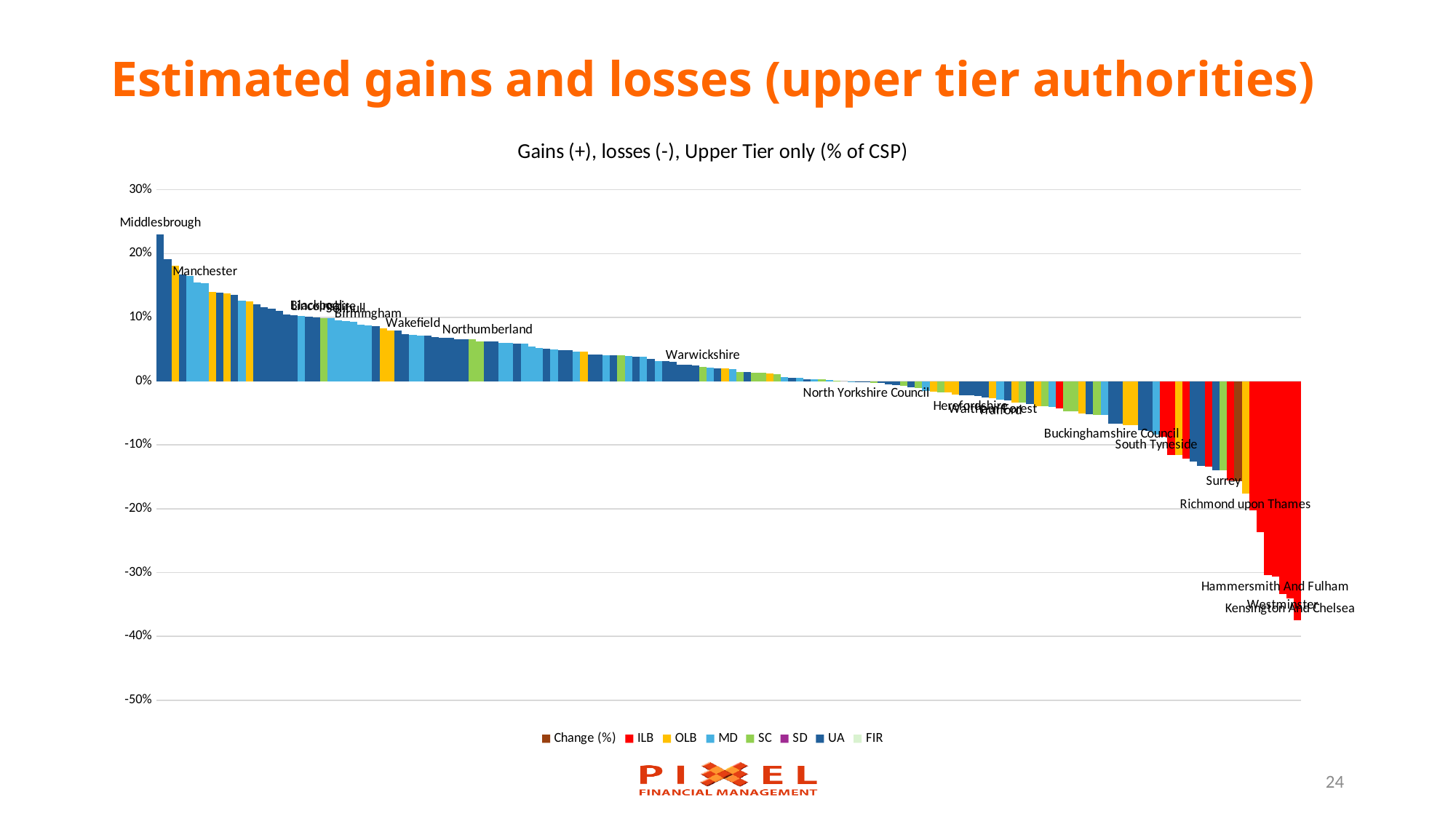
What kind of chart is shown on the slide? bar chart What is the title of the chart? Gains (+), losses (-), Upper Tier only (% of CSP) Is the value for Warwickshire greater or less than 10%? less How many series does the legend list? 8 Is the value for Northumberland greater or less than 10%? less Do the values rise or fall moving from left to right along the x axis? fall Is the value for Manchester greater or less than 10%? greater Which has the larger value, Middlesbrough or Manchester? Middlesbrough Which colour does the legend use for the ILB series? red Which authority has the highest value in the chart? Middlesbrough